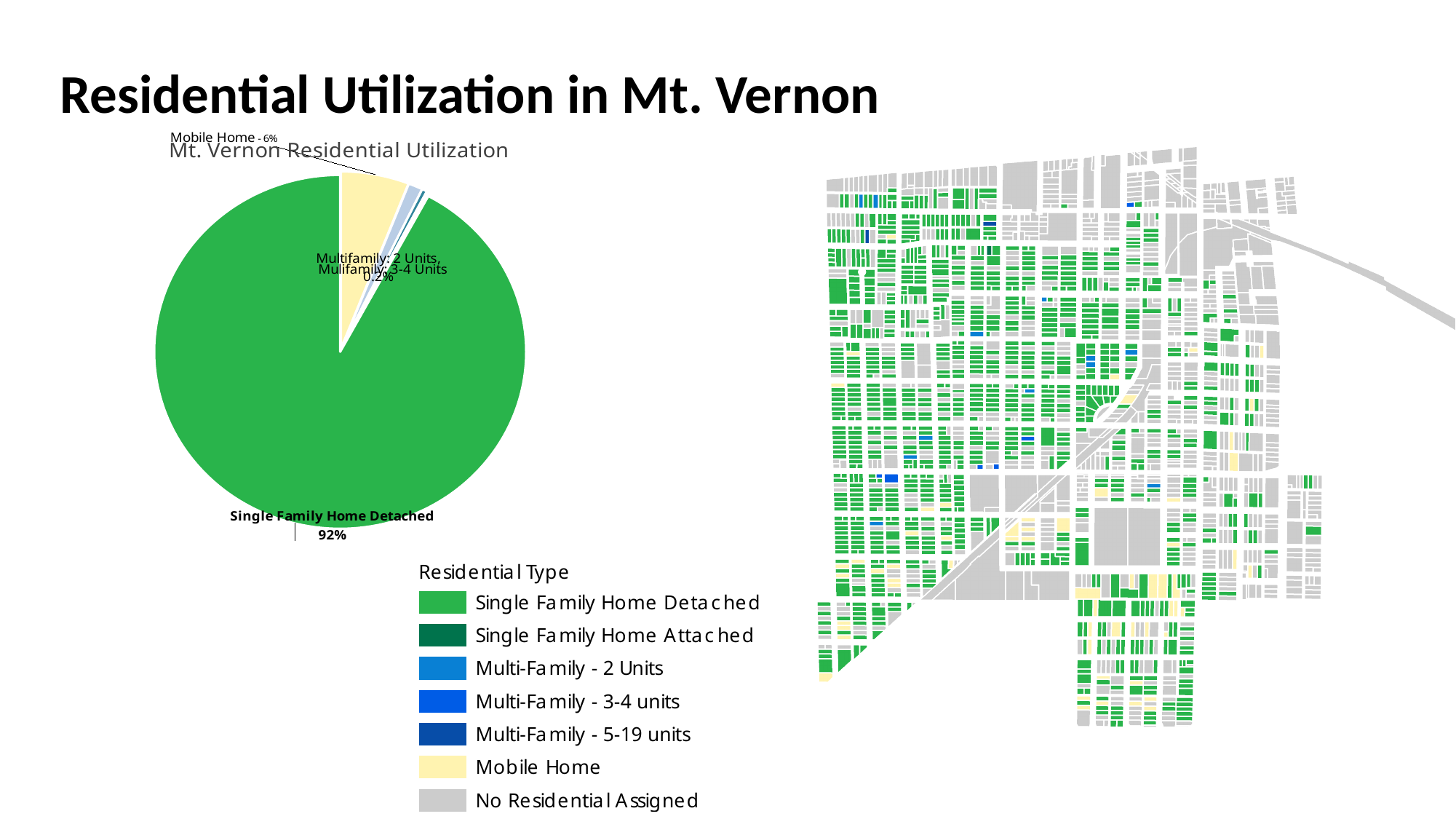
In the pie chart, how many percentage points larger is Single Family Home Detached than Mobile Home? 86 percentage points What is the title of the pie chart? Mt. Vernon Residential Utilization Which category has the largest slice in the pie chart? Single Family Home Detached Does the Single Family Home Detached slice account for more or less than half of the pie chart? More What colour represents Mobile Home in the Residential Type legend? Pale yellow How many entries are listed in the Residential Type legend? 7 How many labelled slices does the pie chart have? 4 In the pie chart, which is larger: Single Family Home Detached or Mobile Home? Single Family Home Detached In the pie chart, what share is shown for Mobile Home? 6% In the pie chart, what share is shown for Single Family Home Detached? 92% What kind of chart is shown on the left of the slide? Pie chart